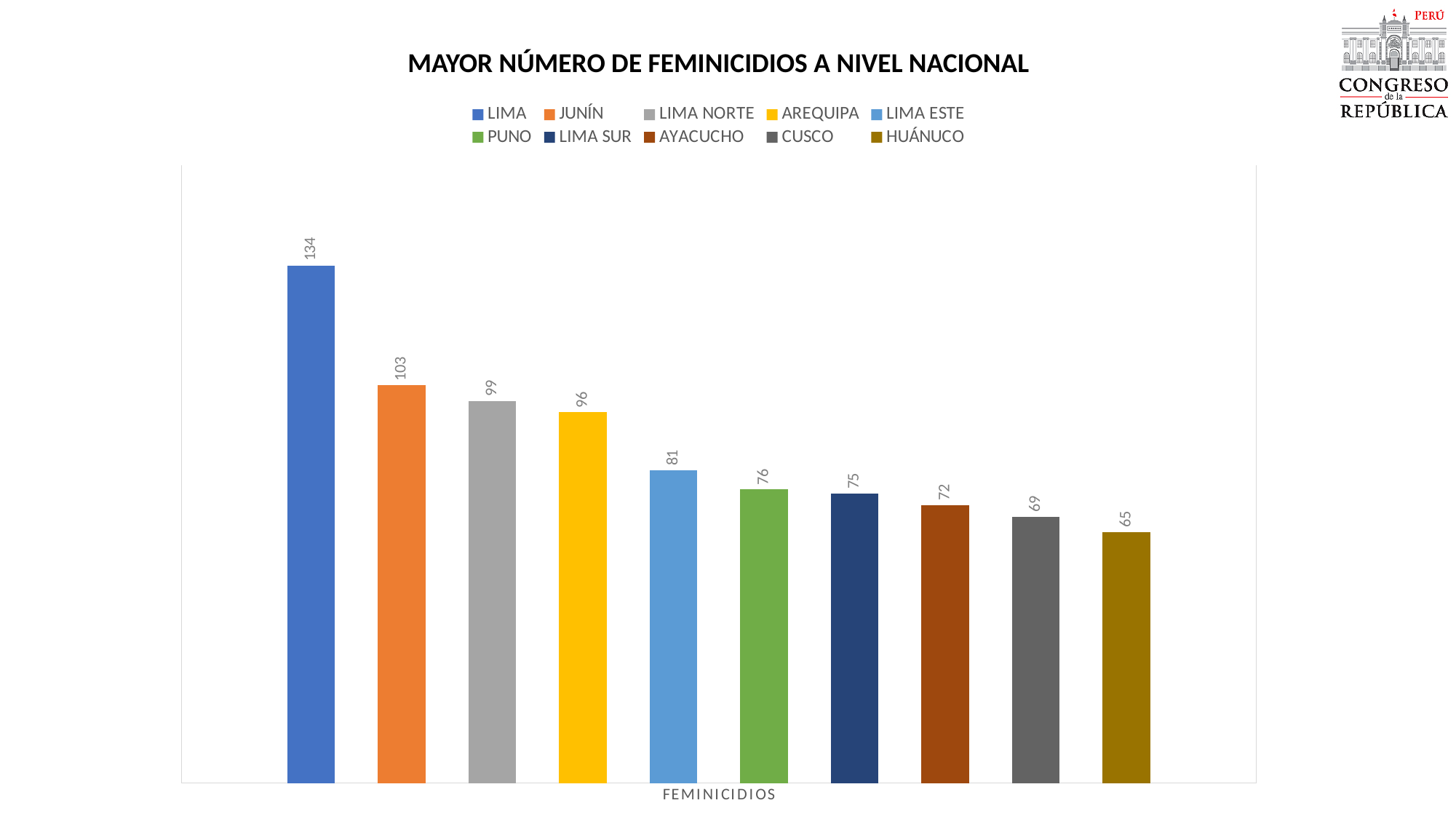
What is the label shown on the x axis below the bars? FEMINICIDIOS What is the value for LIMA? 134 What is the difference between the values for LIMA and JUNÍN? 31 Which series has the lowest value? HUÁNUCO What kind of chart is shown on the slide? bar chart Which is larger, the value for LIMA NORTE or the value for LIMA SUR? LIMA NORTE Which series has the highest value? LIMA What is the value for CUSCO? 69 How many series does the legend list? 10 What is the value for AREQUIPA? 96 What is the difference between the values for LIMA ESTE and PUNO? 5 What is the title of the chart? MAYOR NÚMERO DE FEMINICIDIOS A NIVEL NACIONAL